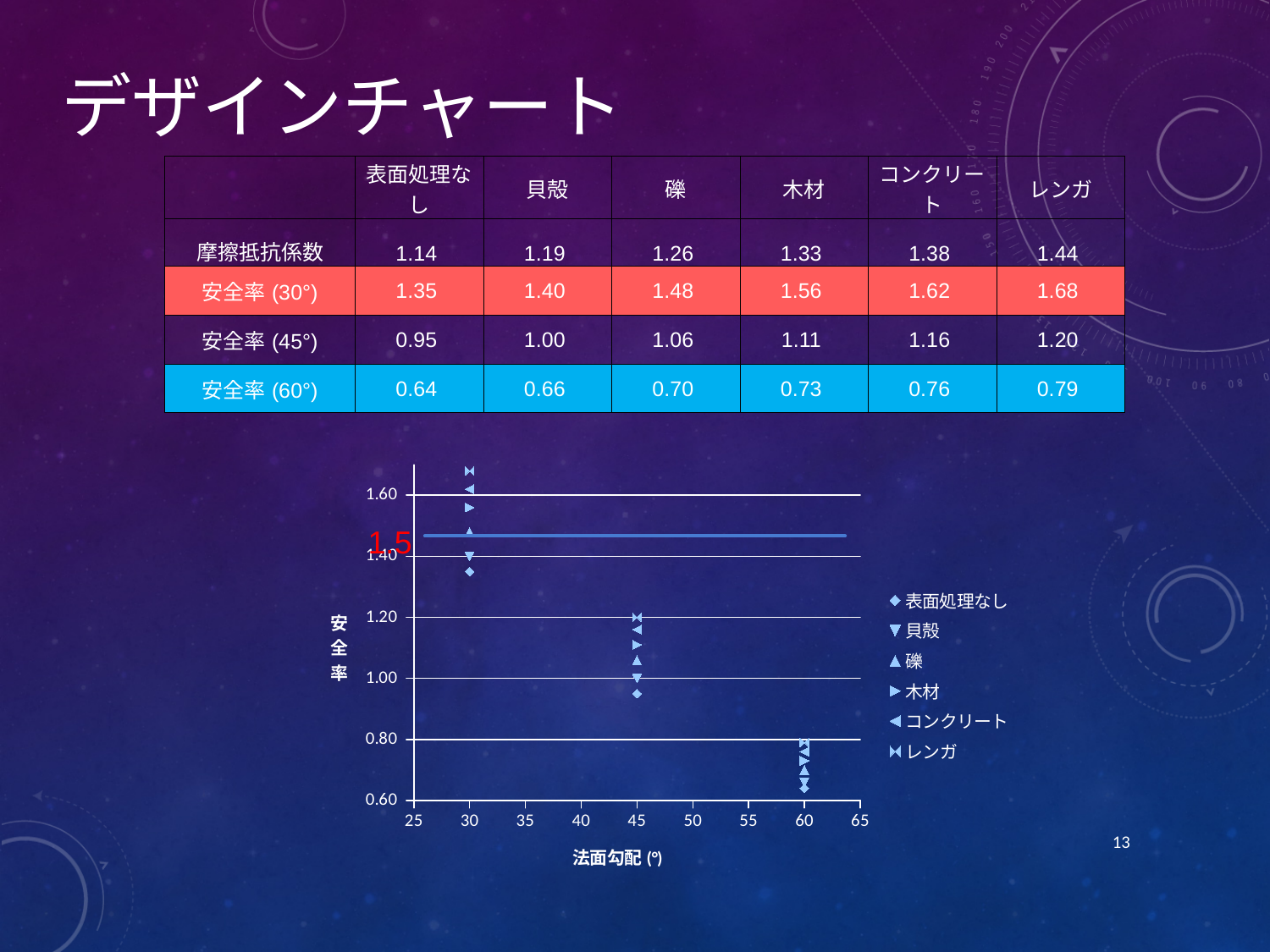
Which series has the lowest safety factor at a slope of 60°? 表面処理なし What is the title of the chart's x axis? 法面勾配 (°) What value is labelled on the horizontal reference line drawn across the chart? 1.5 Is the value for レンガ at a slope of 45° greater or less than 1.00? greater At a slope of 30°, which has the larger safety factor, レンガ or 表面処理なし? レンガ Do the safety factor values rise or fall as the slope angle increases along the x axis? fall What kind of chart is shown on the slide? scatter chart Is the value for レンガ at a slope of 30° greater or less than 1.60? greater Is the value for 表面処理なし at a slope of 30° greater or less than 1.5? less How many series does the chart legend list? 6 At how many slope angle values are points plotted in the chart? 3